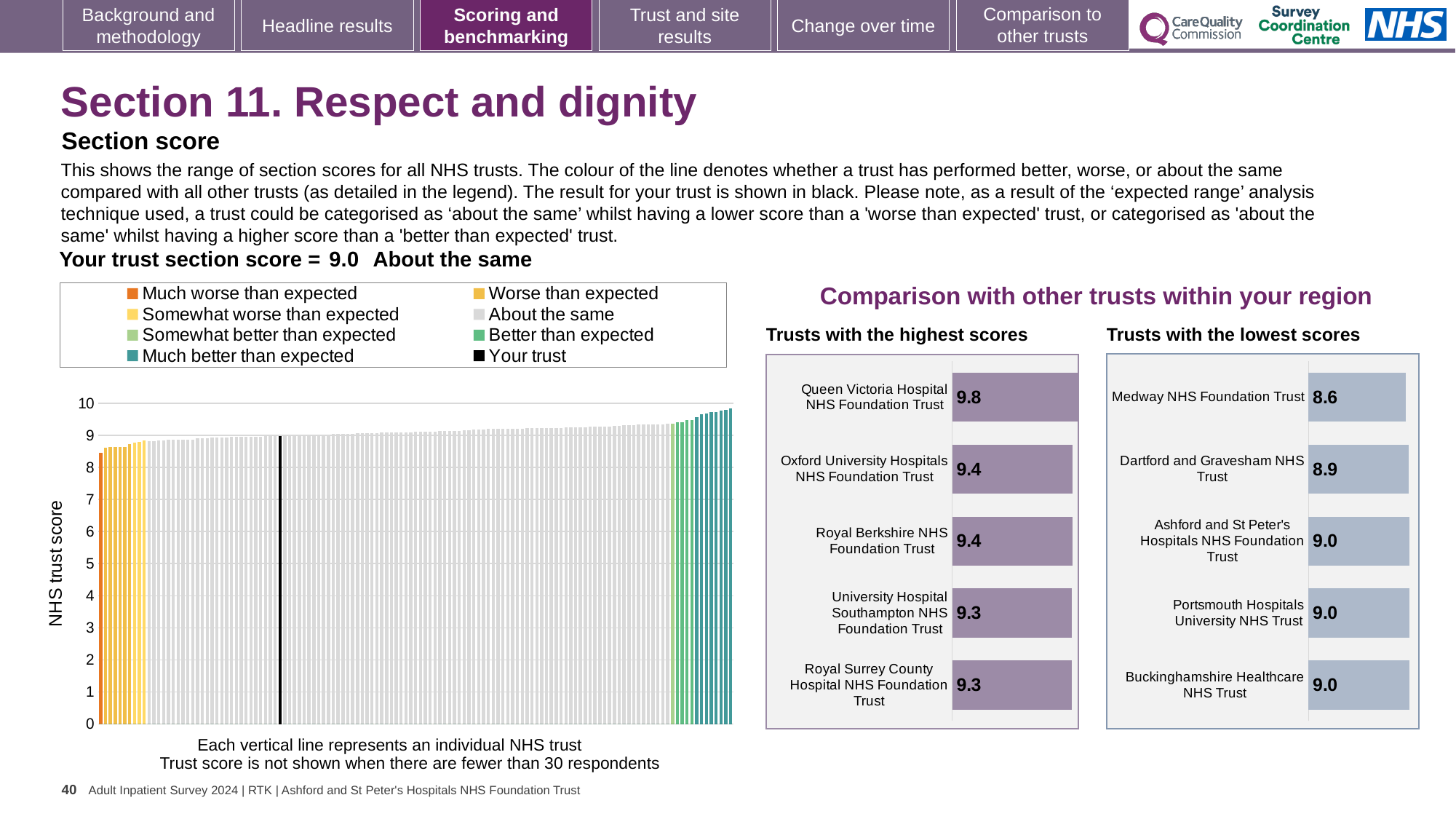
In the 'Trusts with the highest scores' chart, which trust has the highest score? Queen Victoria Hospital NHS Foundation Trust In the 'Trusts with the highest scores' chart, what is the difference between the scores of Queen Victoria Hospital NHS Foundation Trust and Oxford University Hospitals NHS Foundation Trust? 0.4 In the 'Trusts with the lowest scores' chart, what is the difference between the scores of Dartford and Gravesham NHS Trust and Medway NHS Foundation Trust? 0.3 How many entries does the legend of the main chart on the left list? 8 In the 'Trusts with the lowest scores' chart, what is the score for Dartford and Gravesham NHS Trust? 8.9 In the 'Trusts with the lowest scores' chart, which trust has the lowest score? Medway NHS Foundation Trust In the 'Trusts with the highest scores' chart, what is the score for Queen Victoria Hospital NHS Foundation Trust? 9.8 In the 'Trusts with the lowest scores' chart, what is the score for Medway NHS Foundation Trust? 8.6 What kind of chart is the 'Trusts with the lowest scores' chart? Bar chart In the main chart on the left, what is the section score for your trust? 9.0 In the 'Trusts with the highest scores' chart, which has the higher score: Queen Victoria Hospital NHS Foundation Trust or Royal Berkshire NHS Foundation Trust? Queen Victoria Hospital NHS Foundation Trust How many trusts are shown in the 'Trusts with the highest scores' chart? 5